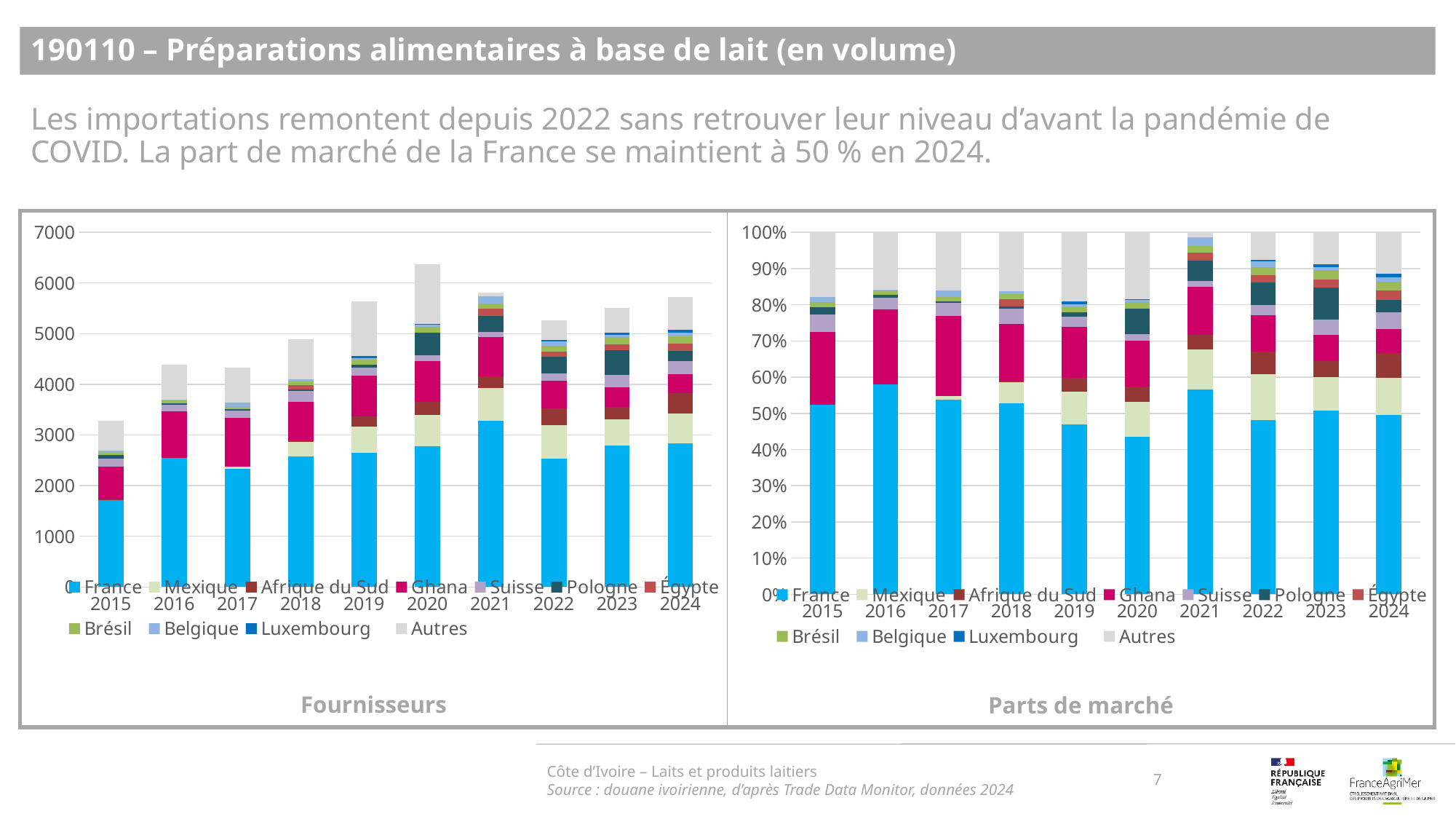
In the 'Parts de marché' chart, which is larger: the share for France in 2016 or in 2020? 2016 In the 'Fournisseurs' chart, which year has the highest total bar? 2020 In the 'Fournisseurs' chart, is the value for France in 2021 greater or less than 3000? greater In the 'Parts de marché' chart, is the share for France in 2020 greater or less than 50%? less Which series is shown in light blue at the bottom of each bar in both charts? France In the 'Fournisseurs' chart, is the total for 2020 greater or less than 6000? greater What kind of chart is the 'Fournisseurs' chart on the left? stacked bar chart In the 'Parts de marché' chart, which year has the lowest share for France? 2020 In the 'Fournisseurs' chart, which year has the lowest total bar? 2015 How many years are shown on the x axis of the 'Fournisseurs' chart? 10 How many series does the legend of the 'Parts de marché' chart list? 11